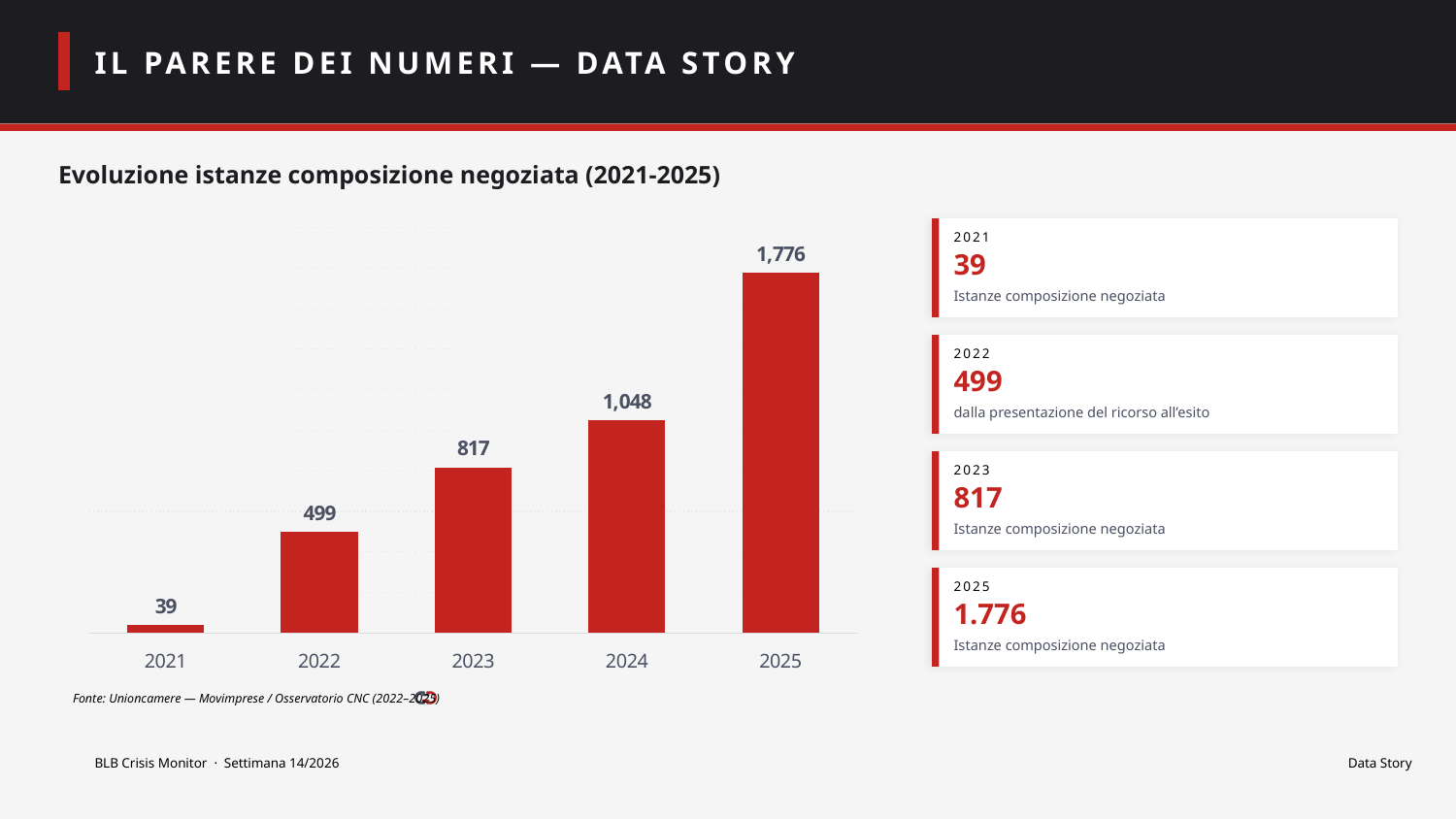
What is the title of the chart? Evoluzione istanze composizione negoziata (2021-2025) Which year has the highest value in the chart? 2025 What kind of chart is shown on the slide? Bar chart What is the value for 2021 in the chart? 39 What is the value for 2023 in the chart? 817 How many years are shown on the x axis of the chart? 5 What is the difference between the values for 2025 and 2024? 728 Which year has the lowest value in the chart? 2021 What is the value for 2024 in the chart? 1,048 Do the values rise or fall from 2021 to 2025? Rise What is the difference between the values for 2022 and 2021? 460 Which is larger, the value for 2023 or the value for 2022? 2023